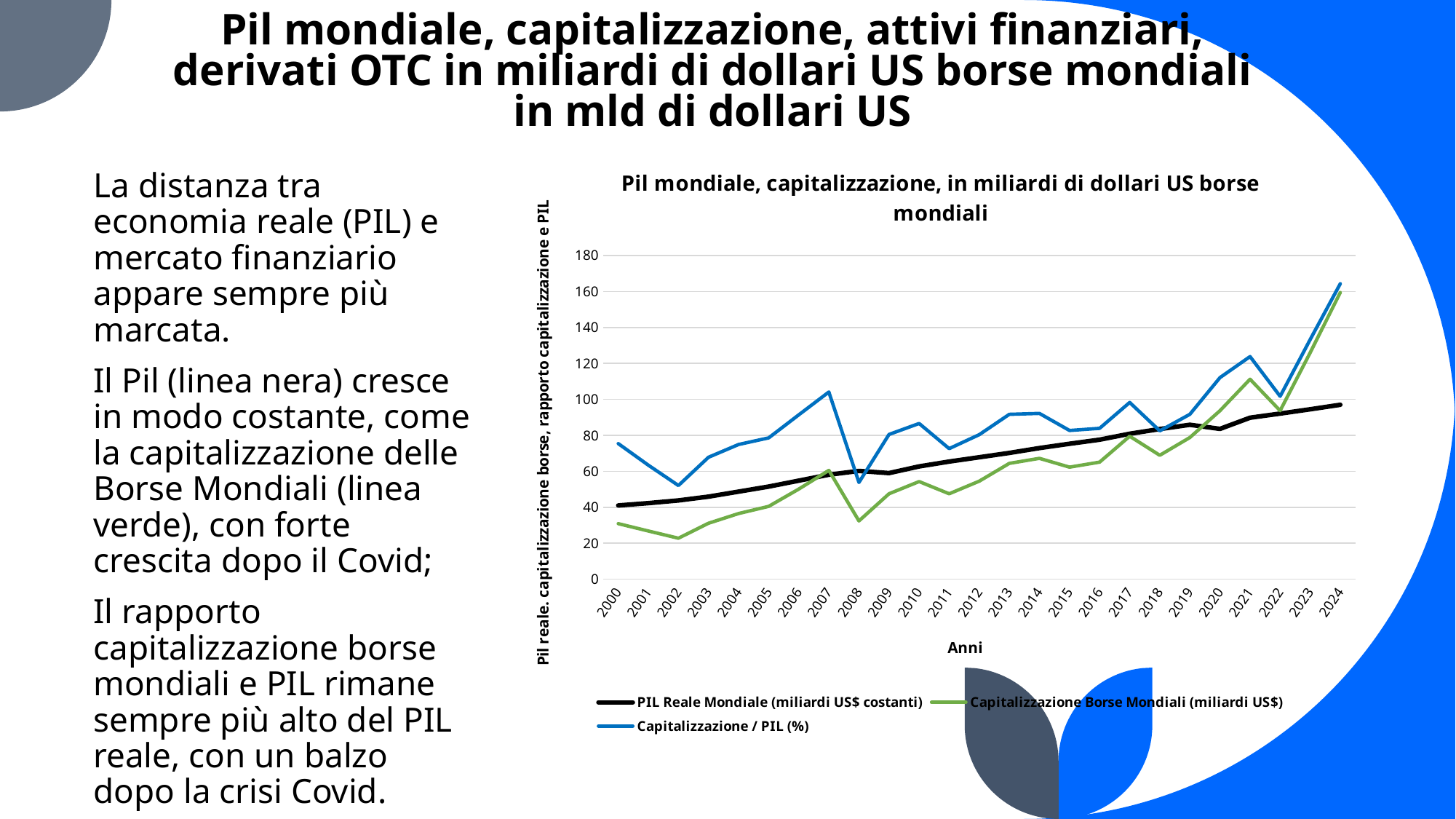
How many years are plotted along the x axis of the chart? 25 Is the value of PIL Reale Mondiale in 2000 greater or less than 60? less In which year does the Capitalizzazione / PIL (%) series reach its highest value? 2024 Which series is drawn with the black line in the chart? PIL Reale Mondiale (miliardi US$ costanti) Is the value of Capitalizzazione / PIL (%) in 2021 greater or less than 100? greater What is the label of the x axis of the chart? Anni What kind of chart is shown on the slide? Line chart How many series does the chart legend list? 3 In 2024, which is larger: Capitalizzazione Borse Mondiali or PIL Reale Mondiale? Capitalizzazione Borse Mondiali In which year does the Capitalizzazione Borse Mondiali series reach its lowest value? 2002 Is the value of Capitalizzazione Borse Mondiali in 2008 greater or less than 40? less